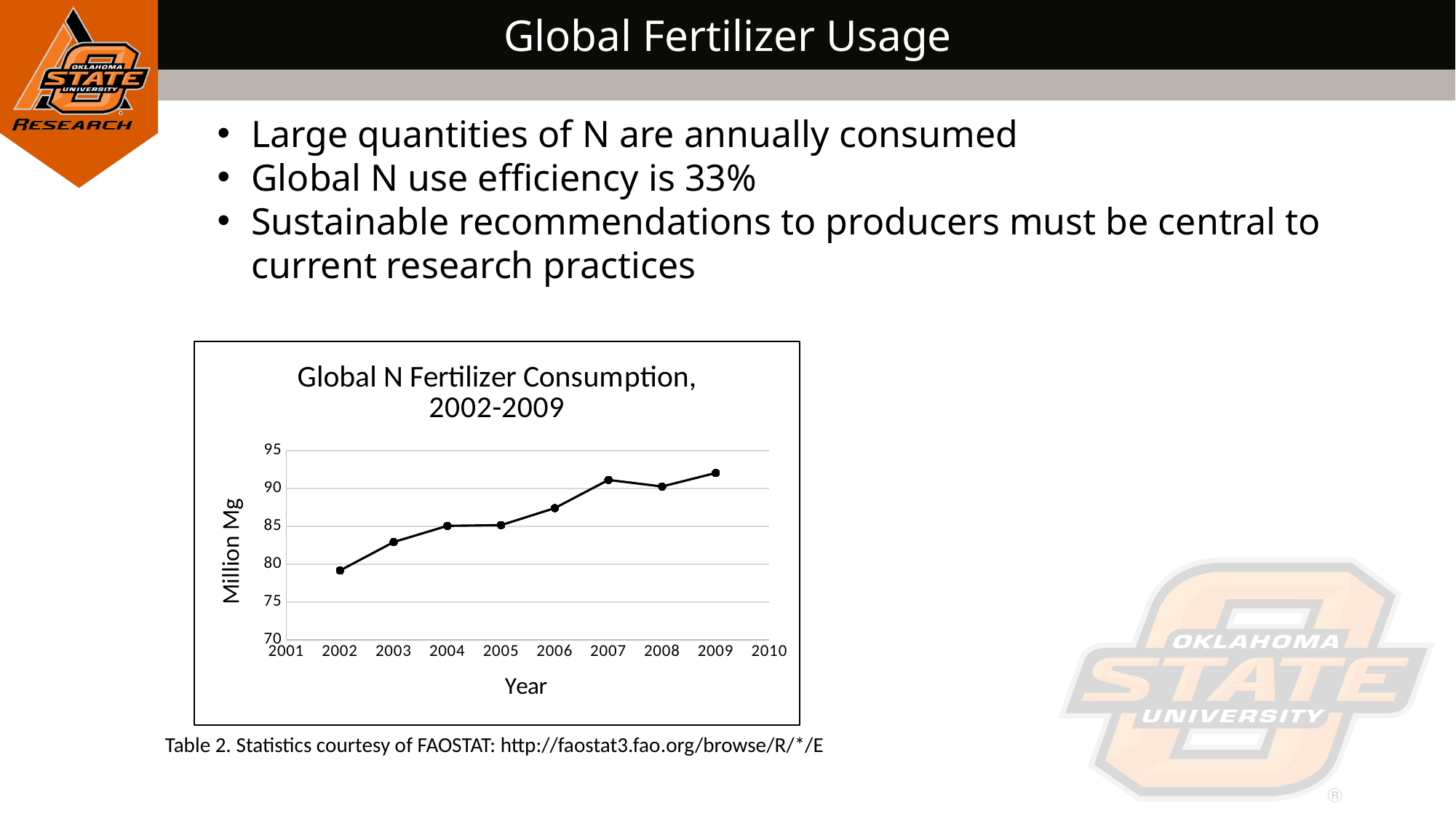
Is the value for 2006 greater or less than 85? greater Does global N fertilizer consumption generally rise or fall from 2002 to 2009? rise Is the value for 2002 greater or less than 80? less How many data points are plotted on the line? 8 Is the value for 2007 greater or less than 90? greater Which year has the lowest global N fertilizer consumption? 2002 What kind of chart is shown on the slide? line chart What is the label of the vertical axis of the chart? Million Mg What is the title of the chart? Global N Fertilizer Consumption, 2002-2009 Which is larger, the value for 2002 or the value for 2009? 2009